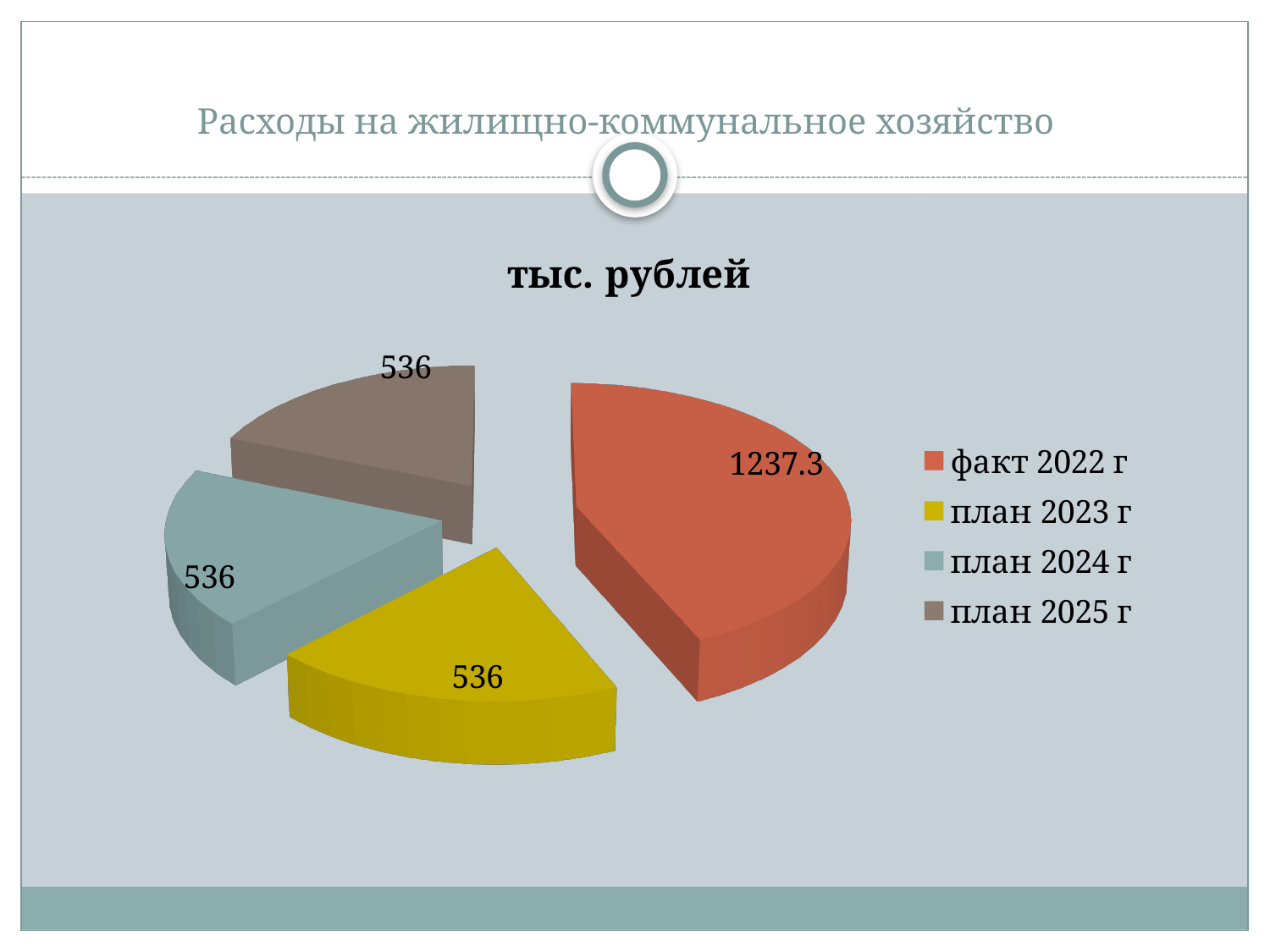
What is the value for план 2024 г? 536 What type of chart is shown on the slide? pie chart What is the title of the chart? тыс. рублей What is the value for факт 2022 г? 1237.3 How many entries does the legend list? 4 Which category has the largest slice of the pie? факт 2022 г What colour is the slice for план 2023 г? yellow What is the value for план 2025 г? 536 What is the difference between the value for факт 2022 г and the value for план 2023 г? 701.3 What is the value for план 2023 г? 536 Which is larger, the value for факт 2022 г or the value for план 2025 г? факт 2022 г How many slices does the pie chart have? 4